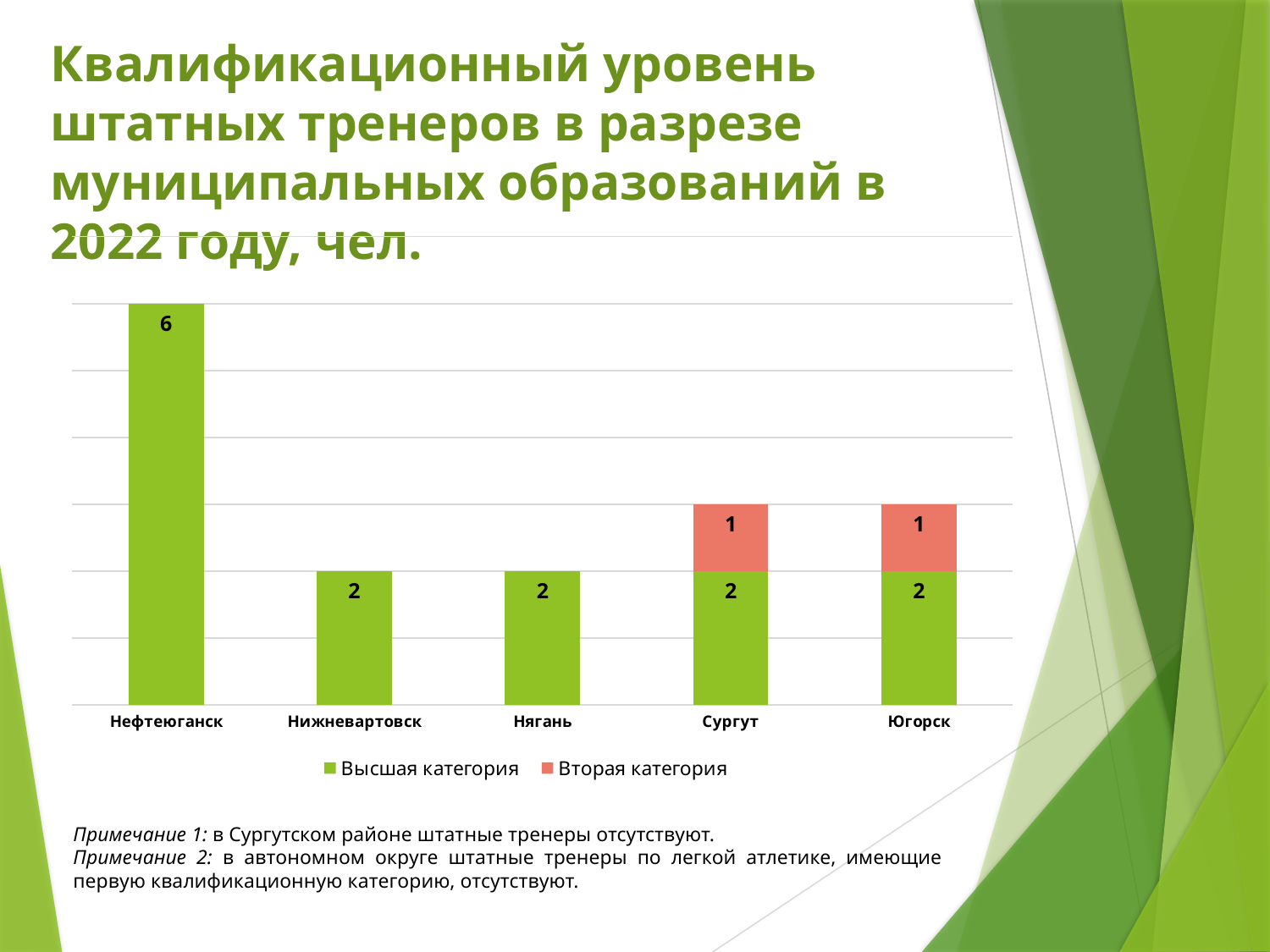
Which municipality has the highest value for Высшая категория? Нефтеюганск How many series does the legend list? 2 What is the value for Вторая категория in Сургут? 1 How many municipalities are shown on the x axis? 5 What is the total of the stacked bar for Югорск? 3 What is the total of the stacked bar for Сургут? 3 What kind of chart is shown on the slide? Stacked bar chart Which is larger: the Высшая категория value for Нефтеюганск or for Нягань? Нефтеюганск What is the value for Высшая категория in Югорск? 2 What is the difference between the Высшая категория values for Нефтеюганск and Нижневартовск? 4 What is the value for Высшая категория in Нефтеюганск? 6 Which colour represents Вторая категория in the chart? Red (salmon)